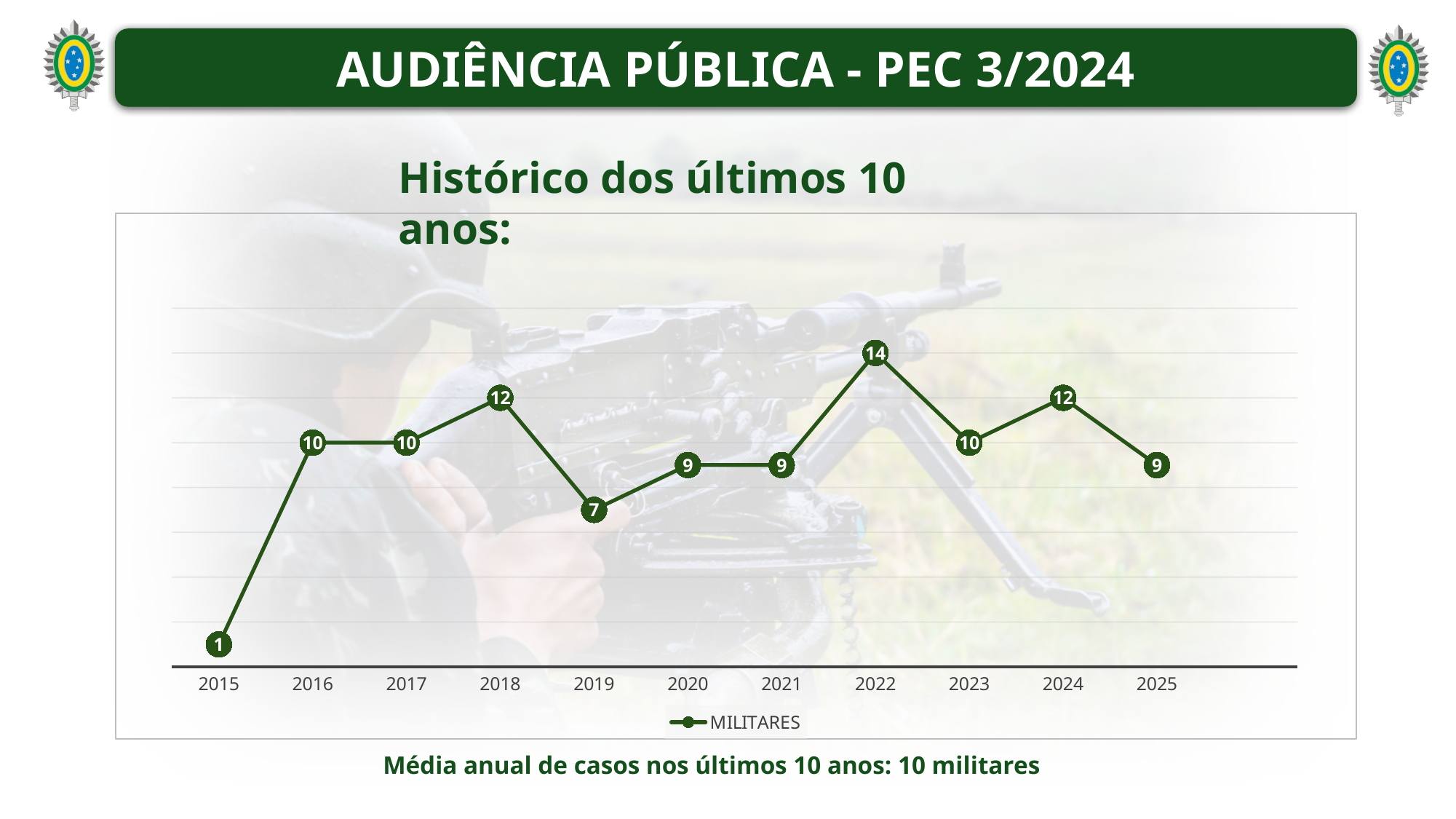
How many series does the legend list? 1 What is the difference between the MILITARES values for 2016 and 2015? 9 How many years are plotted on the x axis? 11 What is the value for MILITARES in 2015? 1 Does the MILITARES value rise or fall from 2024 to 2025? fall What is the difference between the MILITARES values for 2022 and 2019? 7 What kind of chart is shown on the slide? line chart Which year has a larger MILITARES value, 2018 or 2023? 2018 What is the value for MILITARES in 2022? 14 Which year has the lowest value for MILITARES? 2015 What is the value for MILITARES in 2019? 7 Which year has the highest value for MILITARES? 2022